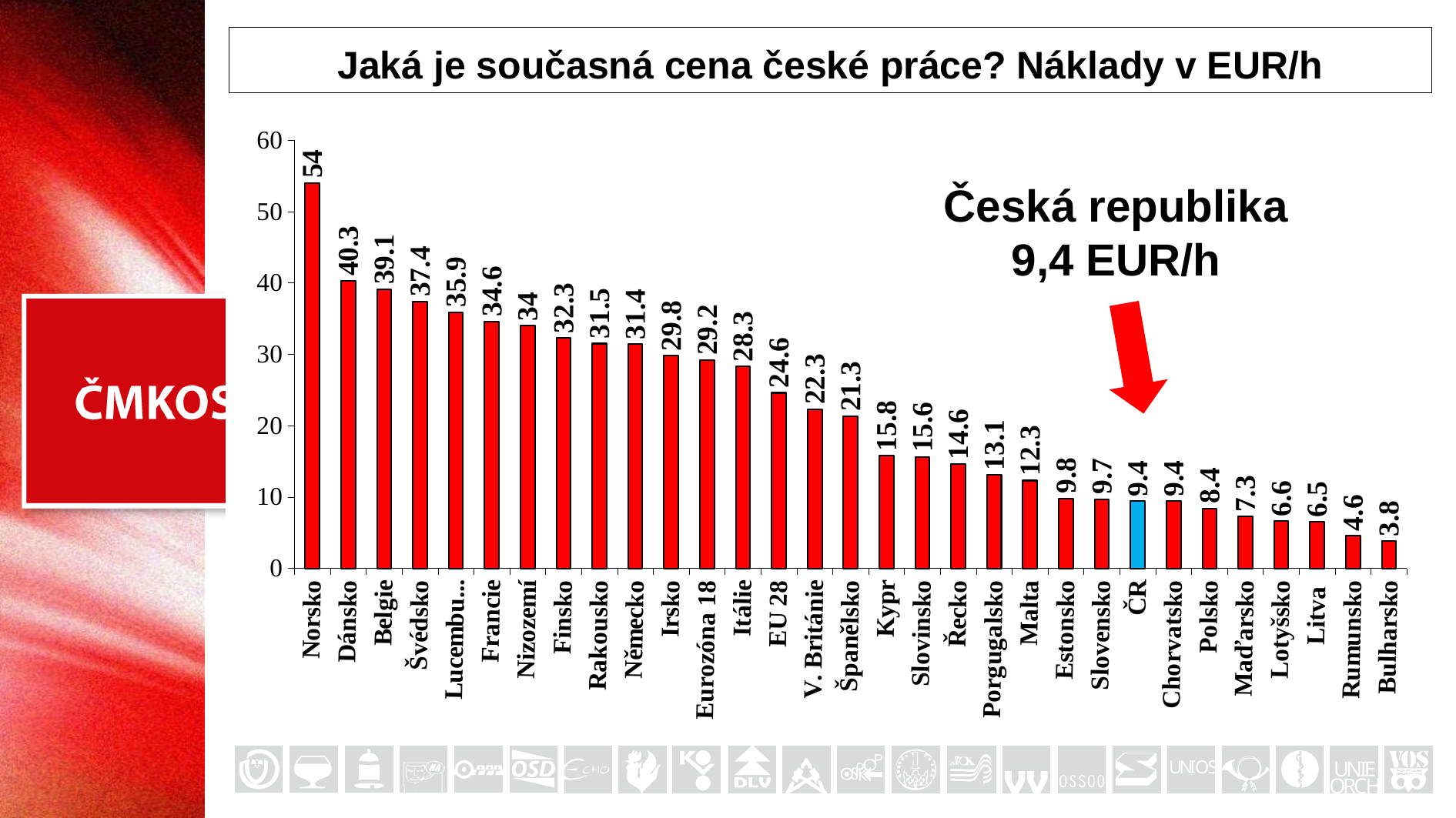
What is the value for ČR? 9.4 What is the value for Bulharsko? 3.8 How many categories are shown on the x axis? 31 What is the value for Norsko? 54 What is the title of the chart? Jaká je současná cena české práce? Náklady v EUR/h What kind of chart is shown on the slide? bar chart Which category has the highest value? Norsko Do the values rise or fall from left to right along the x axis? fall Which is larger, the value for Dánsko or the value for Belgie? Dánsko Which category has the lowest value? Bulharsko What is the difference between the values for Norsko and ČR? 44.6 What is the value for EU 28? 24.6